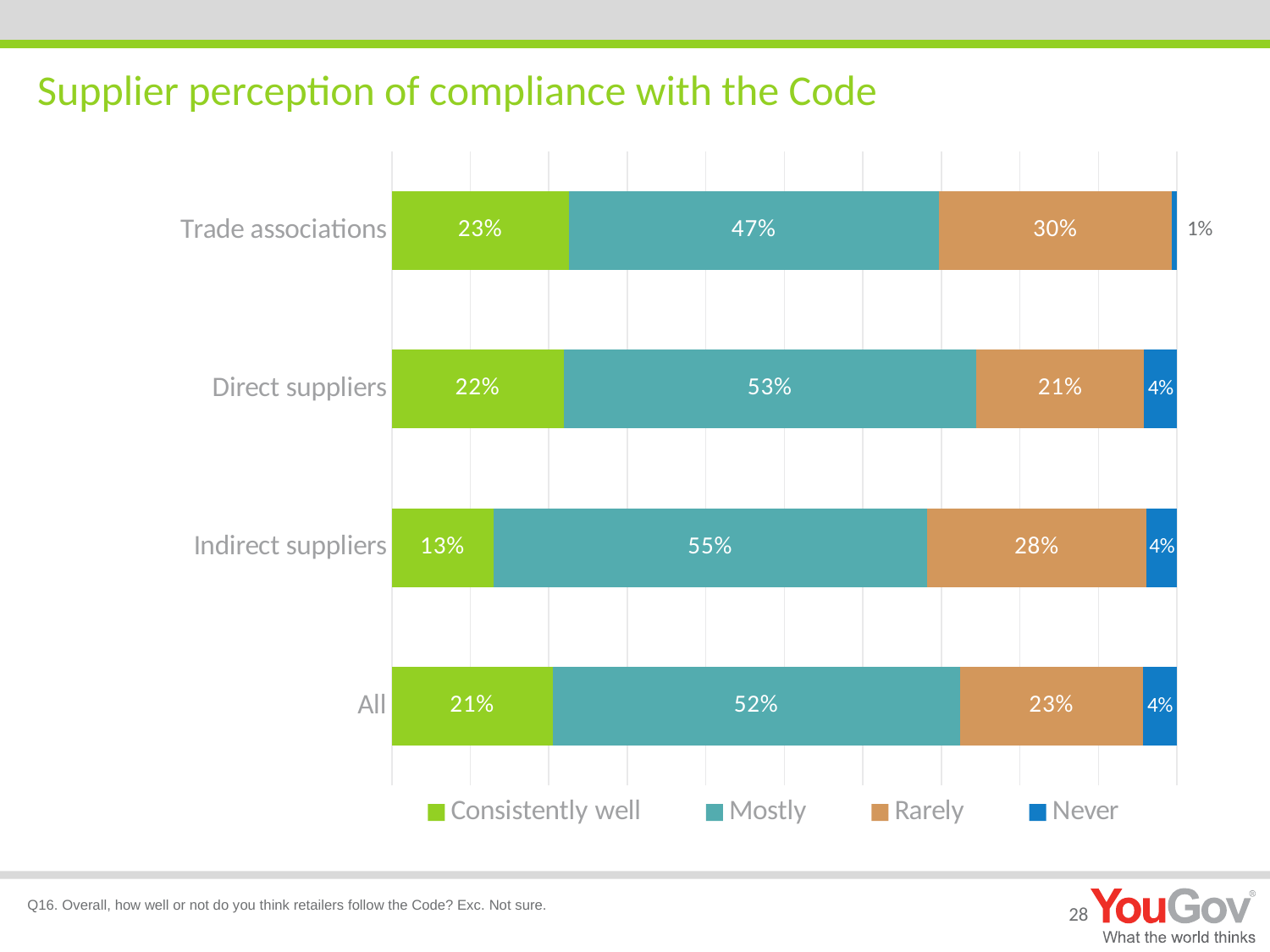
What type of chart is shown on the slide? Stacked bar chart Which is larger: the 'Rarely' value for Indirect suppliers or for Direct suppliers? Indirect suppliers Which category has the lowest 'Consistently well' value? Indirect suppliers What percentage of Trade associations said retailers follow the Code 'Mostly'? 47% Which category has the highest 'Rarely' value? Trade associations What is the difference between the 'Mostly' values for Indirect suppliers and Trade associations? 8% What is the 'Rarely' value for the All category? 23% How many series does the legend list? 4 How many categories are shown on the chart? 4 What is the title of the chart? Supplier perception of compliance with the Code What percentage of Indirect suppliers said 'Consistently well'? 13% What is the 'Never' value for Direct suppliers? 4%